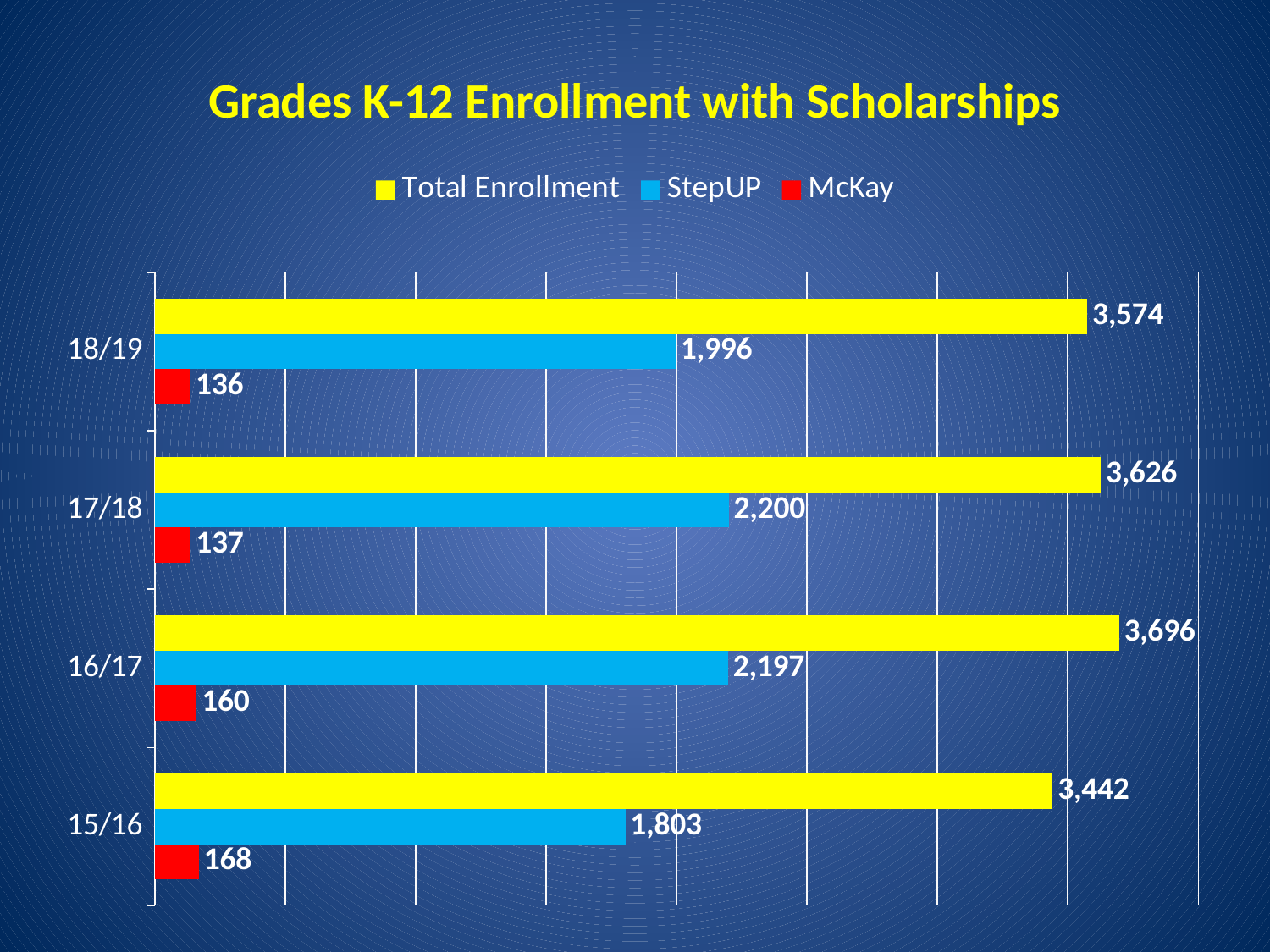
What is the StepUP value for 15/16? 1,803 What is the Total Enrollment value for 18/19? 3,574 What kind of chart is shown on the slide? Bar chart What is the McKay value for 15/16? 168 Which is larger, the StepUP value for 16/17 or for 18/19? 16/17 What is the StepUP value for 17/18? 2,200 How many series does the legend list? 3 Which year has the lowest McKay value? 18/19 Which year has the highest Total Enrollment? 16/17 What is the title of the chart? Grades K-12 Enrollment with Scholarships What is the difference between Total Enrollment in 17/18 and 18/19? 52 How many school years are shown on the chart? 4